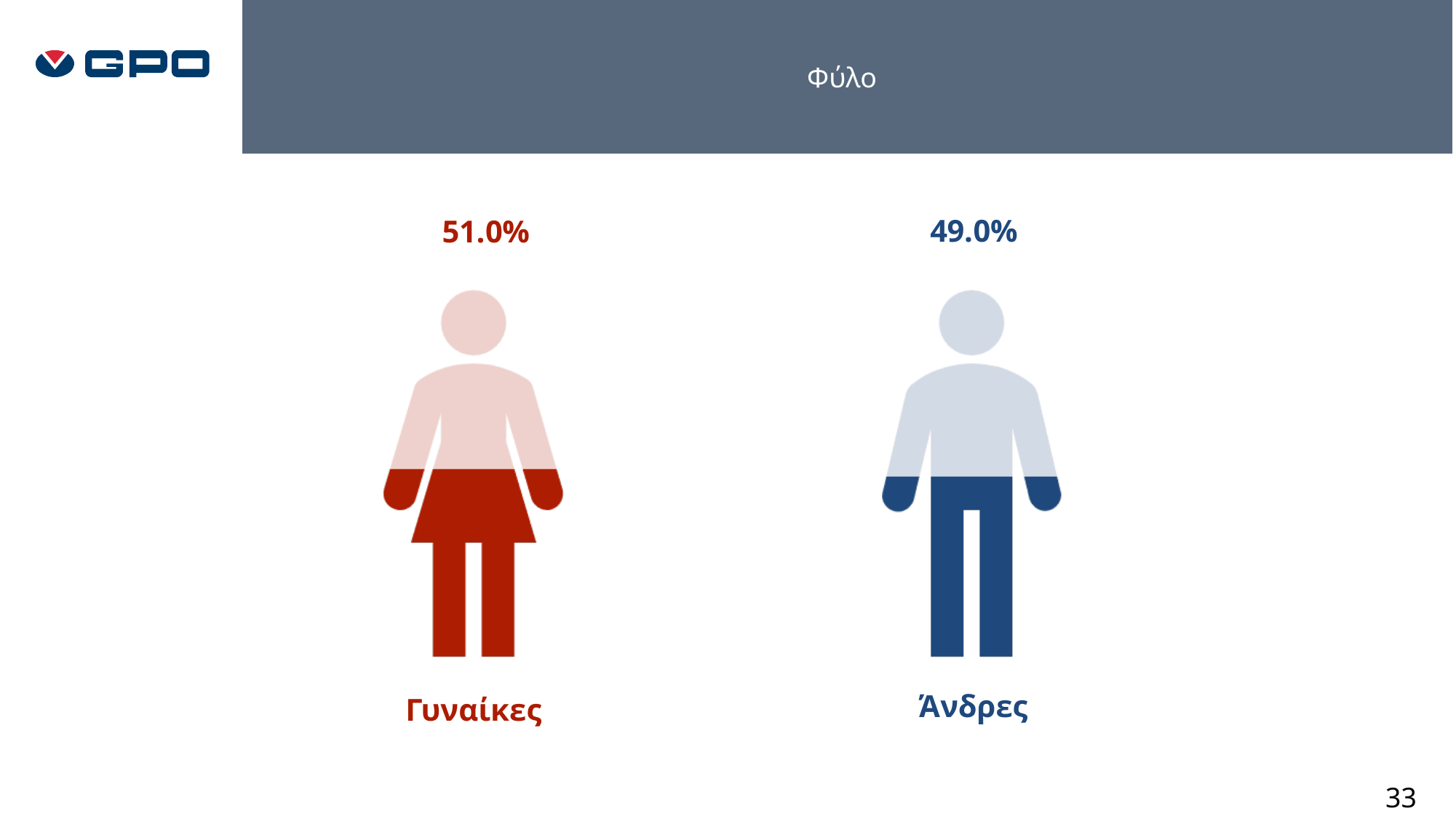
Which category has the lower value? Άνδρες Is the value for Άνδρες larger or smaller than the value for Γυναίκες? smaller What is the title of the chart? Φύλο What is the difference between the values for Γυναίκες and Άνδρες? 2.0% What is the total of the two percentages shown? 100.0% What colour is used for the Άνδρες figure? Blue Which category has the higher value, Γυναίκες or Άνδρες? Γυναίκες What is the value shown for Άνδρες? 49.0% Is the value for Γυναίκες greater or less than 50%? greater How many categories are shown on the slide? 2 What is the value shown for Γυναίκες? 51.0%